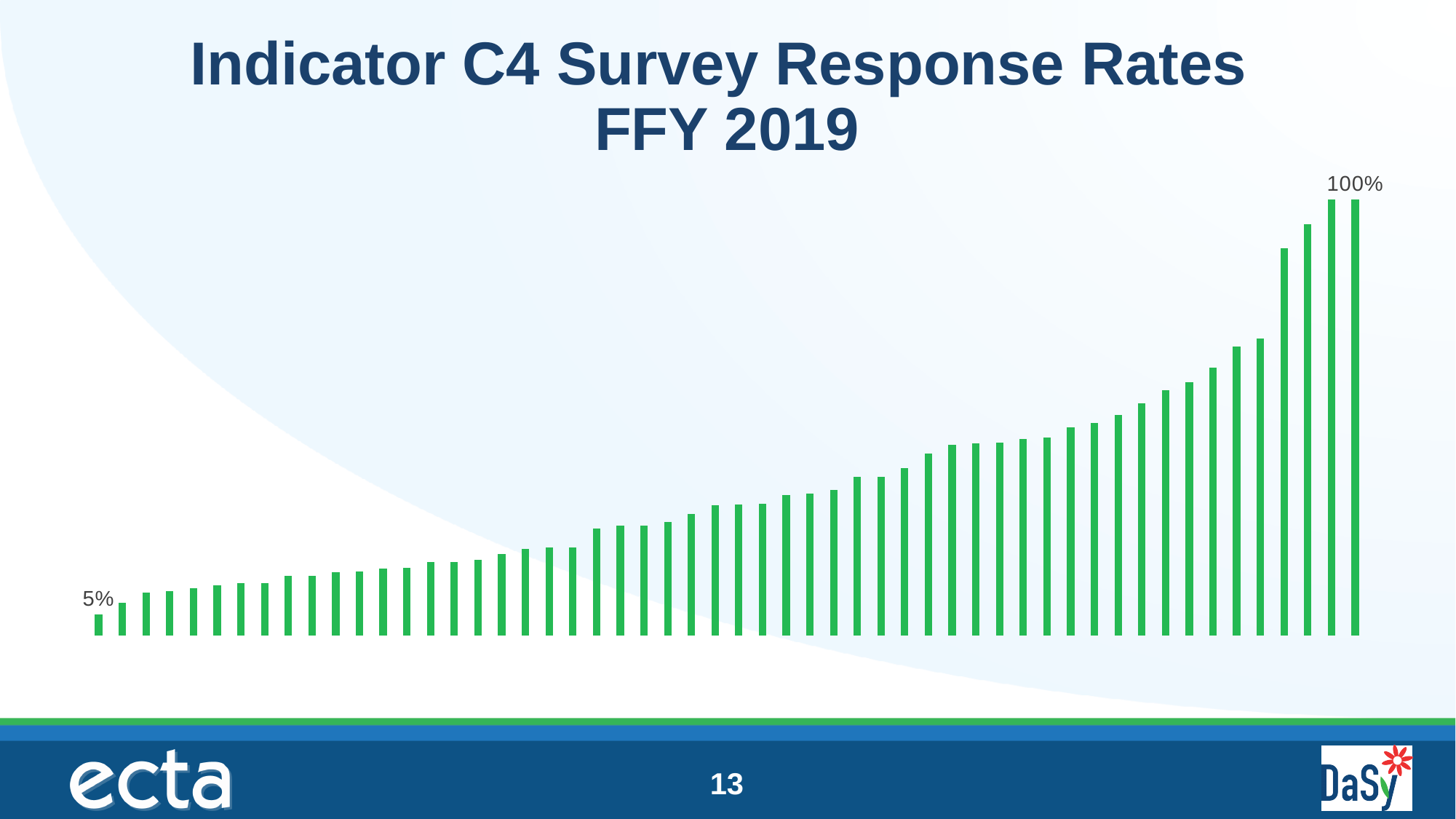
What is the lowest survey response rate shown on the chart? 5% What is the highest survey response rate shown on the chart? 100% What is the title of the chart on the slide? Indicator C4 Survey Response Rates FFY 2019 Do the bar values rise or fall from left to right across the chart? rise What is the difference between the highest labelled value and the lowest labelled value on the chart? 95% What is the value labelled on the tallest (rightmost) bars? 100% What is the value labelled on the shortest (leftmost) bar? 5% Which is larger, the leftmost bar or the rightmost bar? the rightmost bar What kind of chart is shown on the slide? bar chart What colour are the bars in the chart? green How many bars on the chart have a printed data label? 2